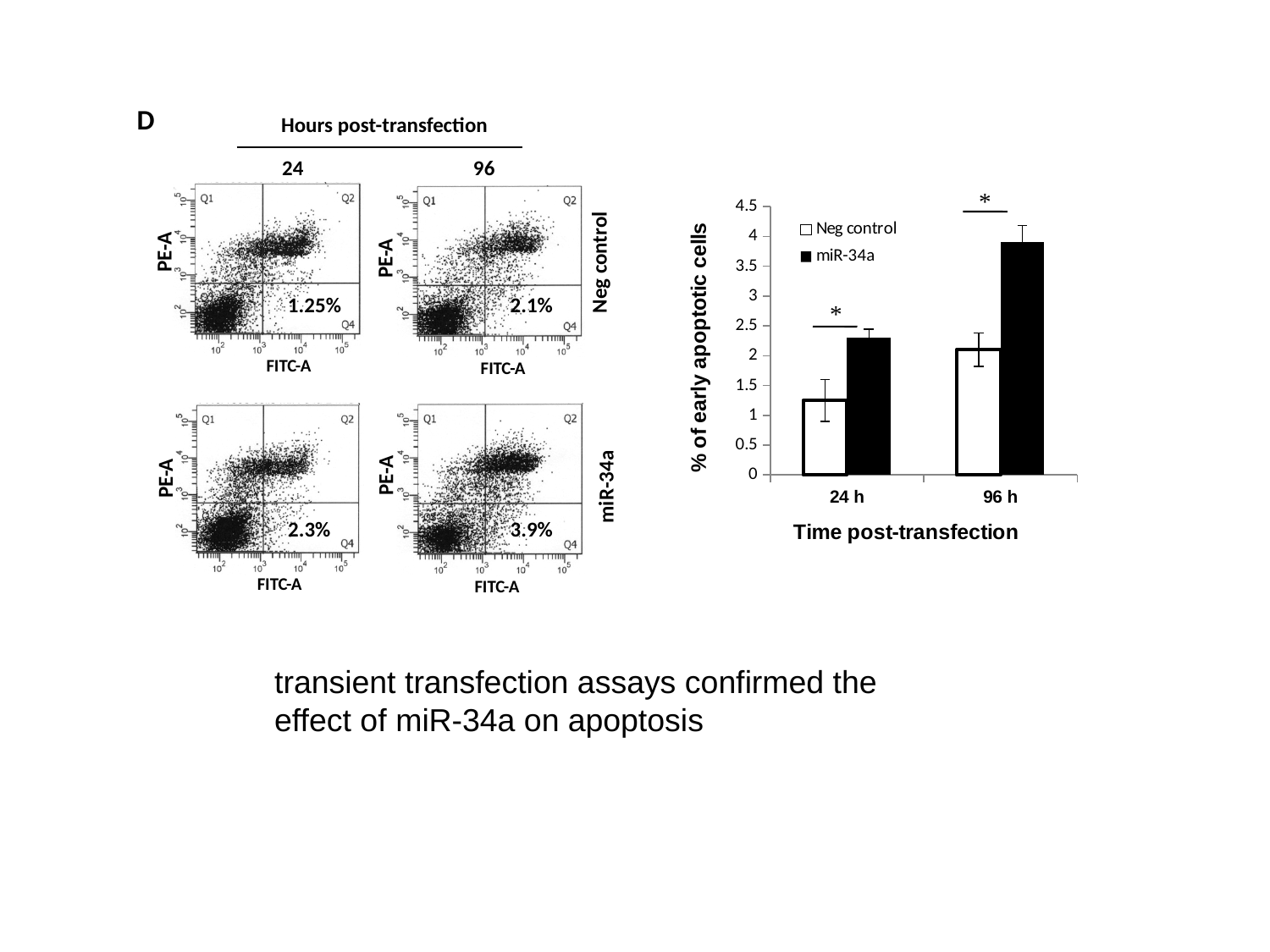
In the bar chart, what is the title of the y axis? % of early apoptotic cells In the bar chart, does the Neg control value rise or fall from 24 h to 96 h? rise In the bar chart, at 96 h, which series has the larger value, Neg control or miR-34a? miR-34a In the bar chart, which bar is the highest? miR-34a at 96 h In the bar chart, how many series does the legend list? 2 What kind of chart is the chart on the right of the slide? bar chart In the bar chart, is the value for miR-34a at 96 h greater or less than 3? greater In the bar chart, what is the title of the x axis? Time post-transfection In the bar chart, how many time-point categories are shown on the x axis? 2 In the bar chart, which bar is the lowest? Neg control at 24 h In the bar chart, is the value for Neg control at 24 h greater or less than 1.5? less In the bar chart, is the value for miR-34a at 24 h greater or less than 2? greater